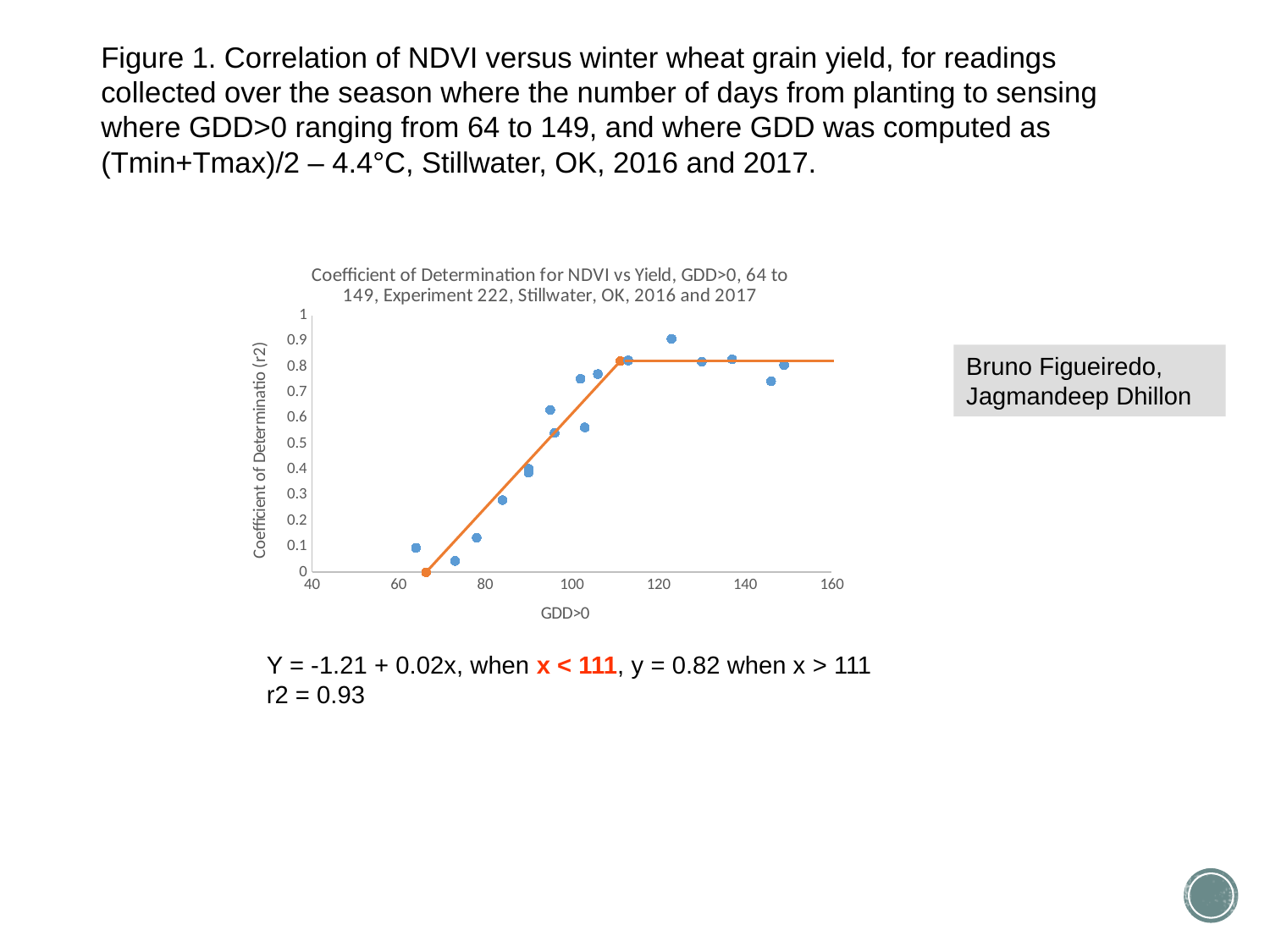
Is the r2 value of the point plotted near GDD>0 = 84 greater or less than 0.4? less What is the label on the y axis of the chart? Coefficient of Determination (r2) Is the r2 value of the point plotted near GDD>0 = 146 greater or less than 0.8? less What kind of chart is shown on the slide? scatter chart Which is larger: the r2 value of the point near GDD>0 = 64 or the point near GDD>0 = 123? the point near GDD>0 = 123 Is the highest plotted point on the chart greater or less than 0.8? greater Do the plotted r2 values generally rise or fall as GDD>0 increases from 60 to 110? rise According to the equation printed below the chart, what is y when x > 111? 0.82 What is the title of the chart? Coefficient of Determination for NDVI vs Yield, GDD>0, 64 to 149, Experiment 222, Stillwater, OK, 2016 and 2017